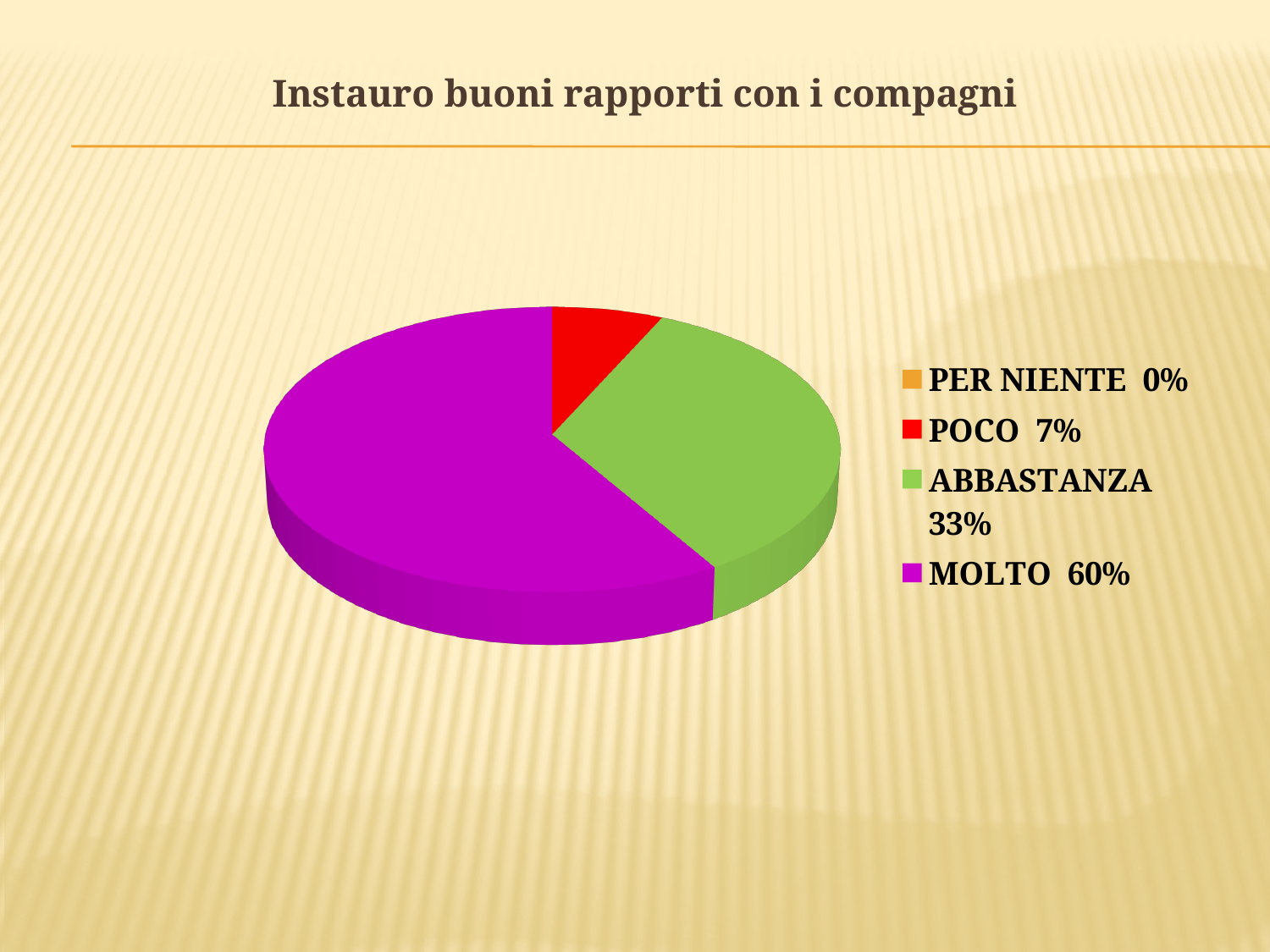
Which is larger, the share for ABBASTANZA or the share for POCO? ABBASTANZA How many categories does the legend list? 4 What percentage is shown for PER NIENTE? 0% What percentage is shown for ABBASTANZA? 33% What kind of chart is shown on the slide? pie chart What percentage is shown for POCO? 7% Which category has the smallest share of the pie? PER NIENTE What percentage is shown for MOLTO? 60% What is the title of the chart? Instauro buoni rapporti con i compagni What is the difference in percentage points between MOLTO and ABBASTANZA? 27 What colour represents MOLTO in the pie chart? purple Which category has the largest share of the pie? MOLTO